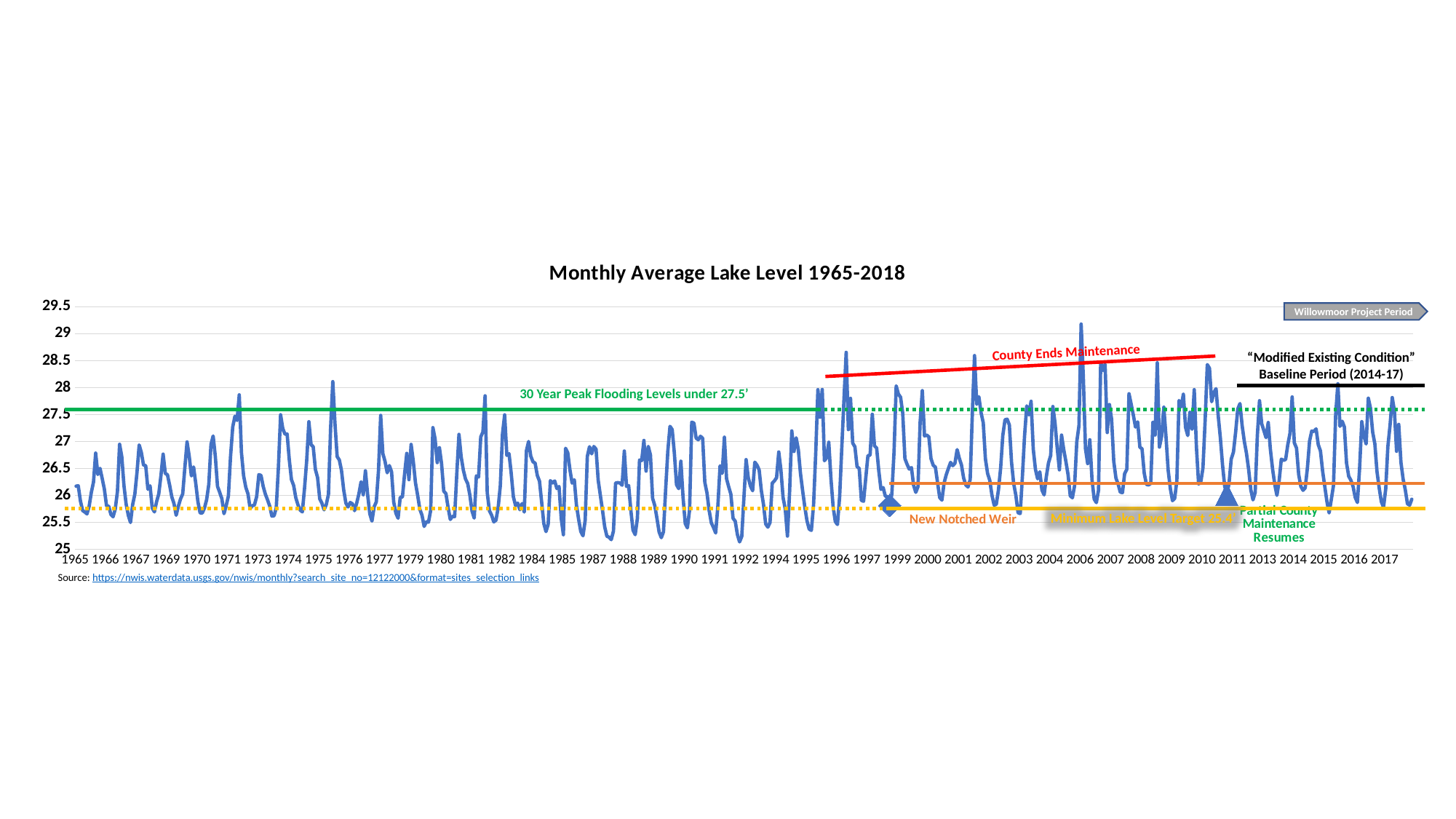
Is the lowest lake level around 1992 greater or less than 25.5? less Is the highest peak of the lake level, around 2006, greater or less than 29? greater Is the peak lake level in 1985 greater or less than 27.5? less What is the title of the chart? Monthly Average Lake Level 1965-2018 What level does the green line labelled '30 Year Peak Flooding Levels' indicate the peaks stayed under? 27.5' Which years does the 'Modified Existing Condition' Baseline Period cover? 2014-17 What is the Minimum Lake Level Target shown on the chart? 25.4' What kind of chart is shown on the slide? Line chart What is the highest value shown on the vertical axis? 29.5 In which year does the lake level reach its highest peak on the chart? 2006